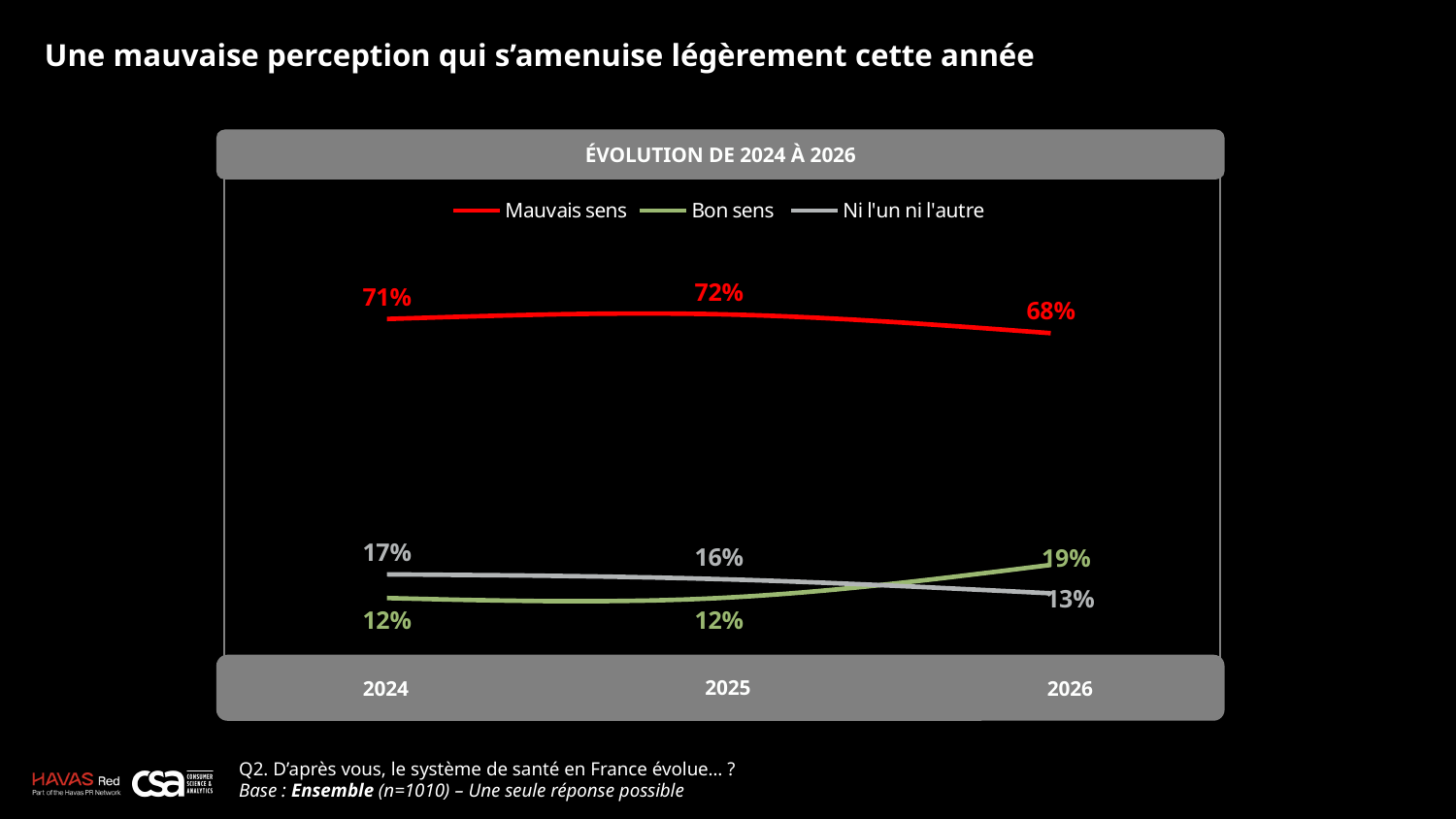
How many series does the legend list? 3 In which year is "Ni l'un ni l'autre" lowest? 2026 What is the title of the chart? ÉVOLUTION DE 2024 À 2026 Does "Bon sens" rise or fall from 2025 to 2026? Rise What is the difference between "Mauvais sens" in 2025 and in 2026? 4 percentage points What kind of chart is shown? Line chart In 2026, which is larger: "Bon sens" or "Ni l'un ni l'autre"? Bon sens What is the value for "Mauvais sens" in 2026? 68% How many years are shown on the x axis? 3 What is the value for "Ni l'un ni l'autre" in 2025? 16% What is the value for "Bon sens" in 2024? 12% In which year is "Mauvais sens" highest? 2025